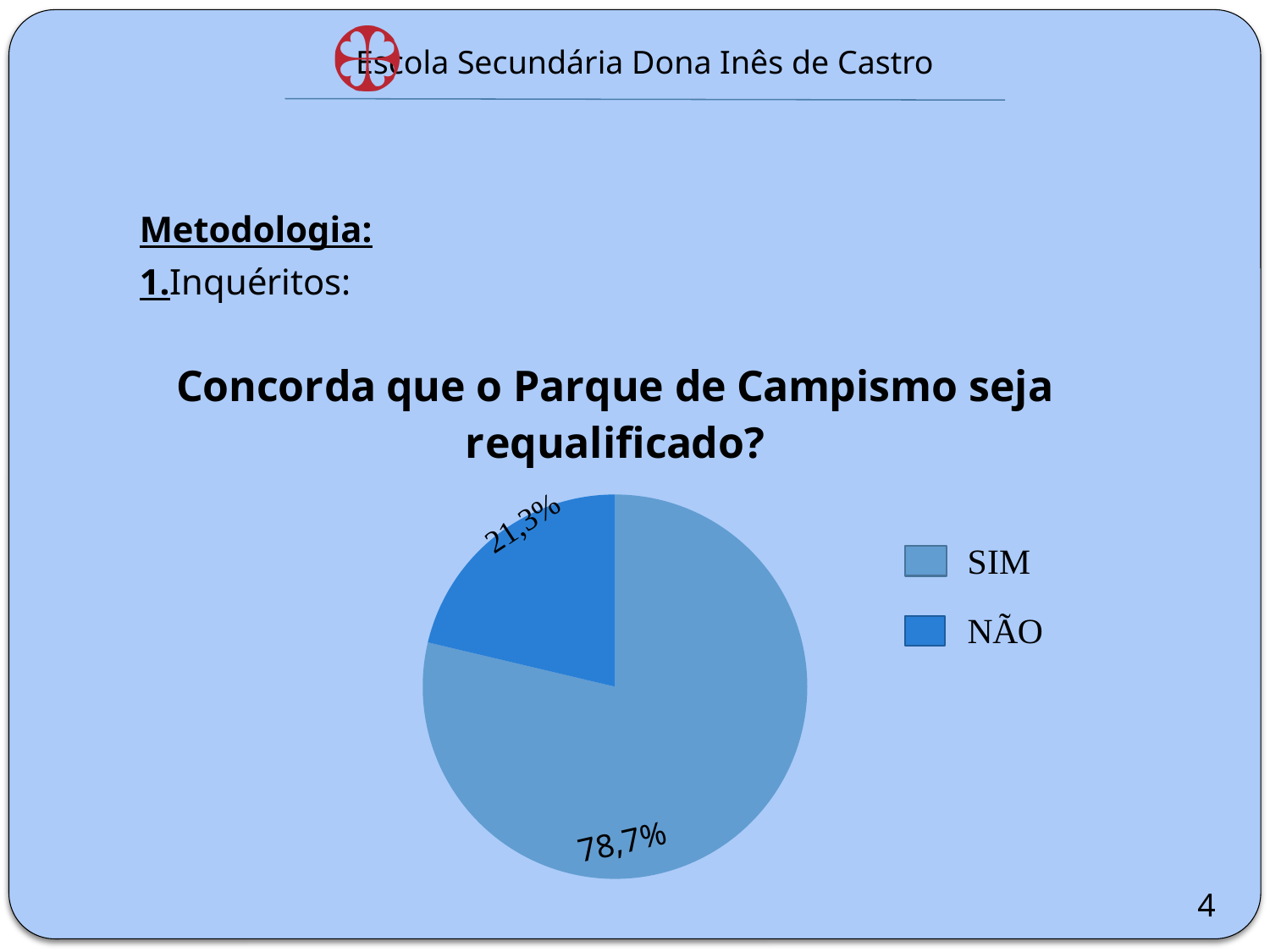
What share of the pie does the NÃO slice represent? 21,3% How many entries does the legend list? 2 What type of chart is shown on the slide? pie chart Which is larger, the SIM slice or the NÃO slice? SIM How many slices does the pie chart have? 2 Which legend entry is shown in the darker blue colour? NÃO What percentage of respondents answered NÃO? 21,3% What percentage of respondents answered SIM? 78,7% What is the difference in percentage points between the SIM and NÃO slices? 57,4 What is the title of the chart? Concorda que o Parque de Campismo seja requalificado? Which response has the smallest share of the pie? NÃO Which response has the largest share of the pie? SIM